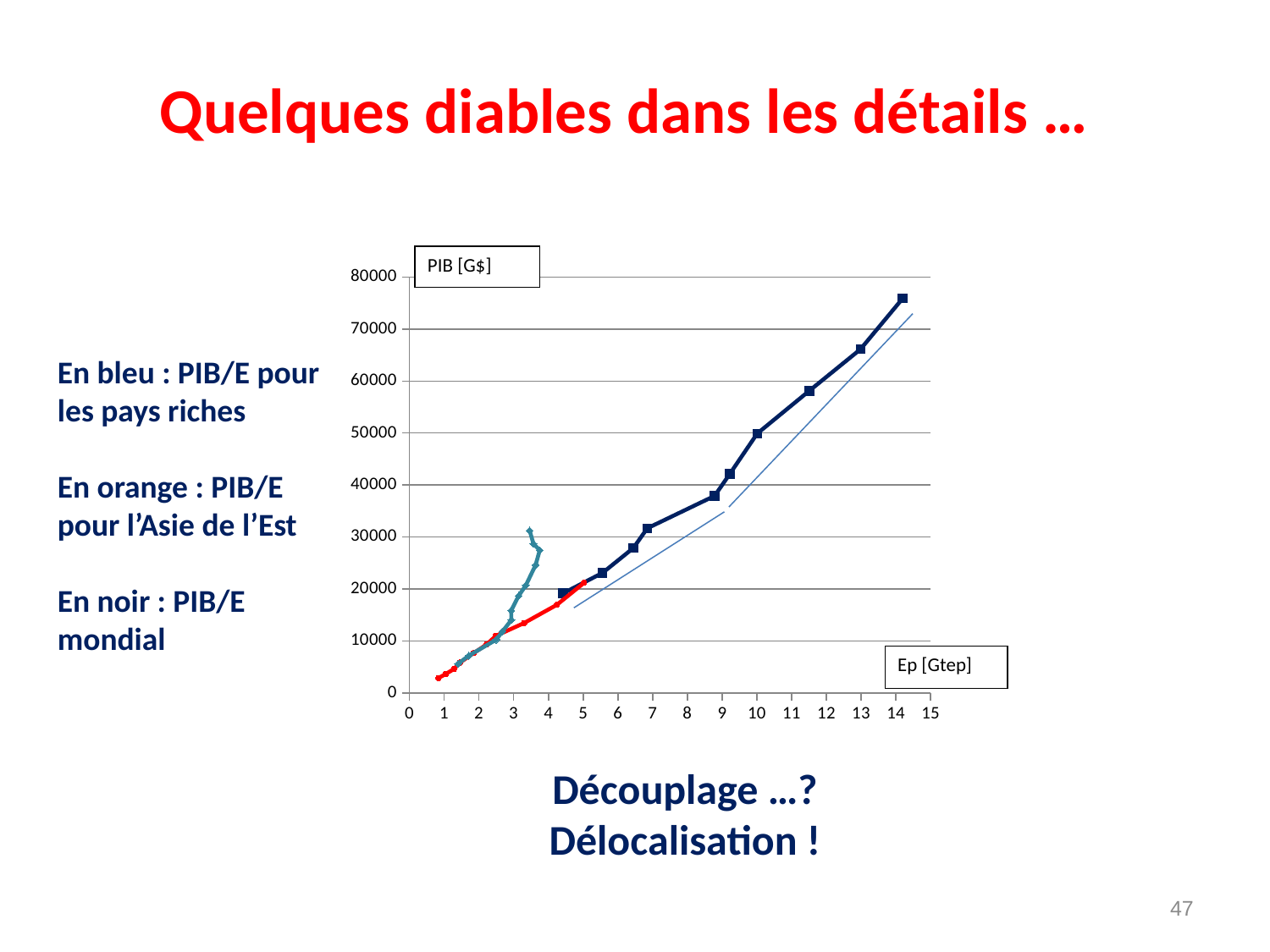
How many series are plotted on the chart, according to the colour descriptions on the slide? 3 Does the black (world) series rise or fall as Ep increases along the x axis? rise Which series reaches the highest PIB value on the chart: the black (world) series or the blue (rich countries) series? the black (world) series What kind of chart is shown on the slide? Line chart Is the PIB value of the highest point of the blue (rich countries) series greater or less than 40000? less What is the label of the vertical axis of the chart? PIB [G$] Is the PIB value of the last point of the orange (East Asia) series greater or less than 30000? less What is the highest value shown on the vertical axis of the chart? 80000 Which series extends furthest to the right along the Ep axis? the black (world) series Is the PIB value of the highest point of the black (world) series greater or less than 70000? greater What is the highest value shown on the horizontal axis of the chart? 15 What is the label of the horizontal axis of the chart? Ep [Gtep]